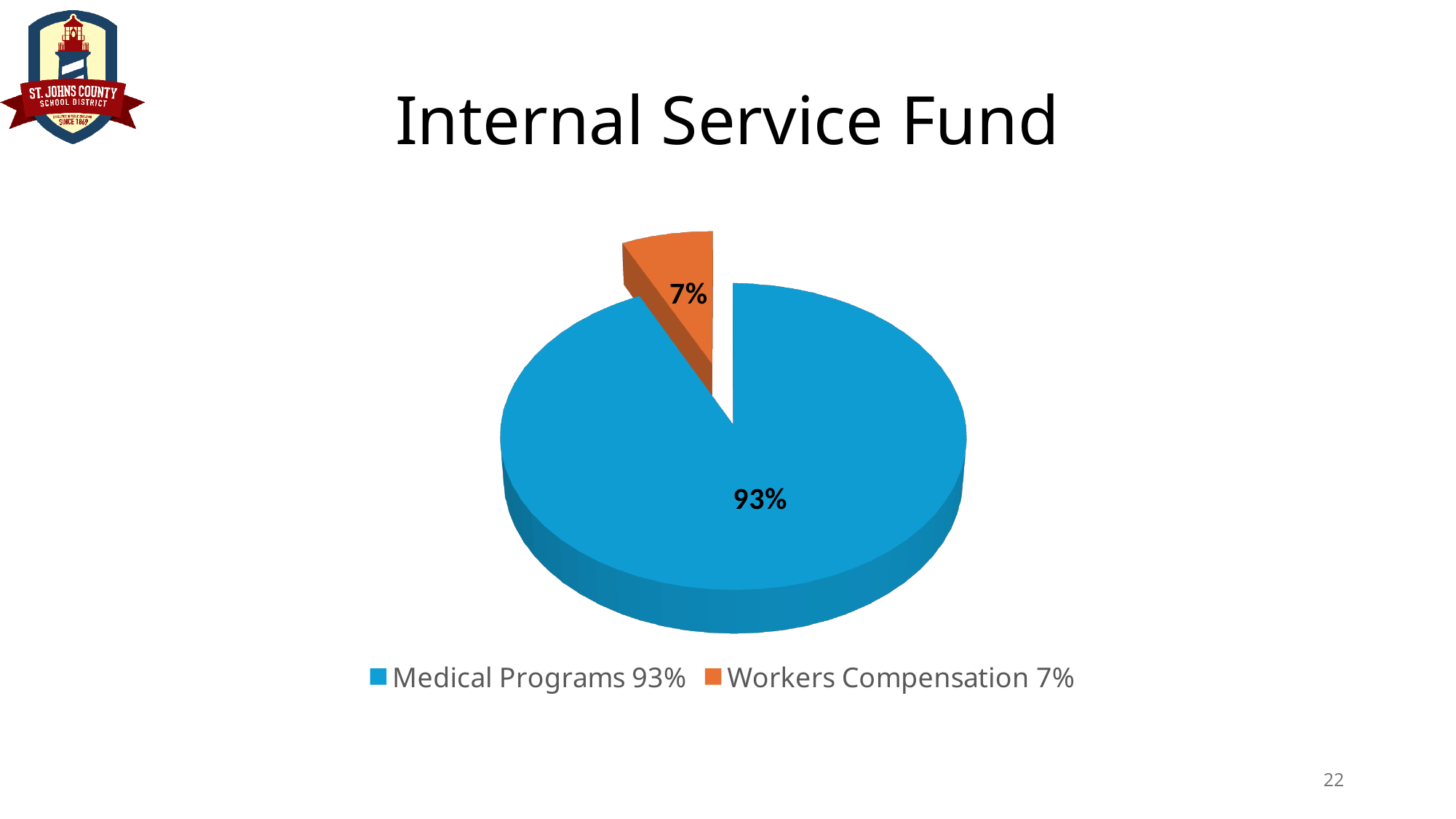
What is the title of the slide containing the chart? Internal Service Fund What share of the pie does Medical Programs represent? 93% Which category has the largest slice of the pie? Medical Programs Which category has the smallest slice of the pie? Workers Compensation What kind of chart is shown on the slide? Pie chart What is the difference in percentage points between Medical Programs and Workers Compensation? 86 What share of the pie does Workers Compensation represent? 7% How many categories are shown in the pie chart? 2 What colour is the Workers Compensation slice? Orange What is the total of the two slices shown in the pie chart? 100% Which is larger, the Medical Programs slice or the Workers Compensation slice? Medical Programs